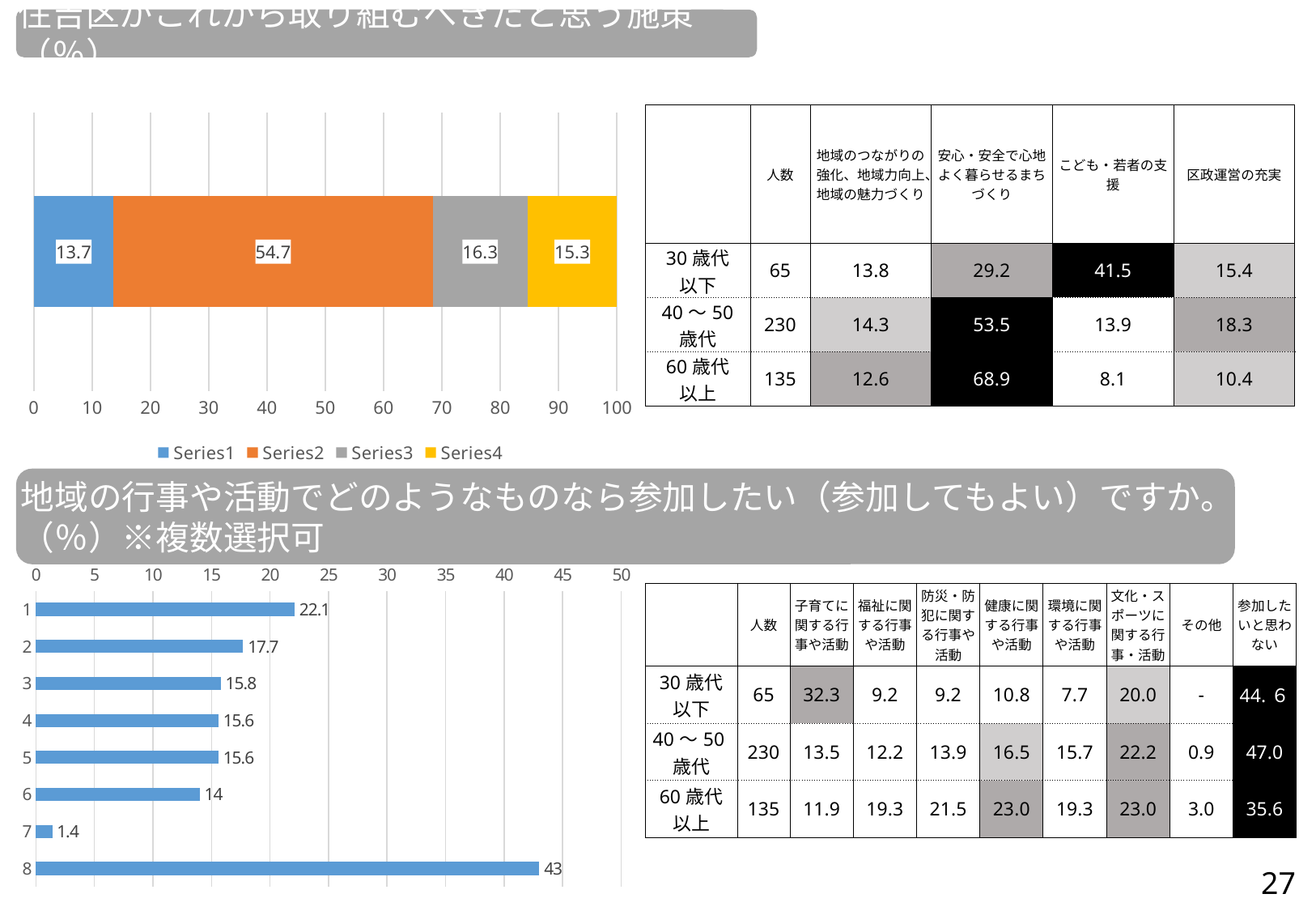
In the bottom chart, how many categories are plotted? 8 What kind of chart is the bottom chart? bar chart In the top chart, what is the difference between the values for Series3 and Series4? 1.0 In the top chart, which series has the largest value? Series2 In the bottom chart, what is the value for category 8? 43 In the top chart, what is the value for Series2? 54.7 In the bottom chart, which category has the highest value? 8 In the top chart, which series has the smallest value? Series1 In the top chart, what is the value for Series1? 13.7 What is the total of the stacked bar in the top chart? 100 In the bottom chart, what is the value for category 7? 1.4 How many series does the legend of the top chart list? 4